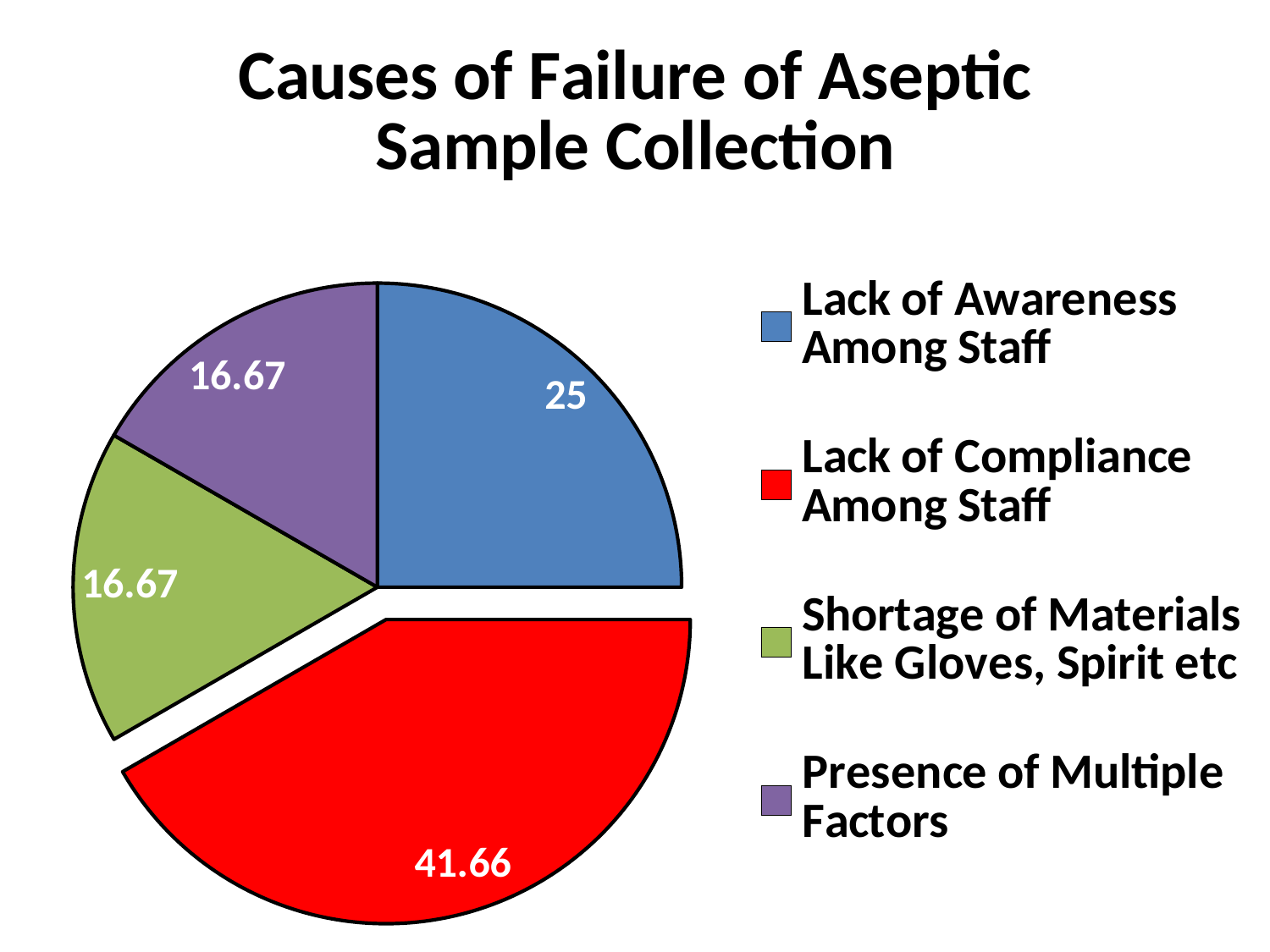
Which is larger, the value for Lack of Awareness Among Staff or the value for Shortage of Materials Like Gloves, Spirit etc? Lack of Awareness Among Staff What kind of chart is shown on the slide? Pie chart What is the value for Shortage of Materials Like Gloves, Spirit etc? 16.67 How many categories are shown in the pie chart? 4 Which category is shown in red? Lack of Compliance Among Staff What is the value for Lack of Compliance Among Staff? 41.66 What is the title of the chart? Causes of Failure of Aseptic Sample Collection What is the value for Lack of Awareness Among Staff? 25 What is the difference between the values for Lack of Compliance Among Staff and Lack of Awareness Among Staff? 16.66 What is the value for Presence of Multiple Factors? 16.67 What is the difference between the values for Lack of Awareness Among Staff and Presence of Multiple Factors? 8.33 Which category has the largest slice of the pie? Lack of Compliance Among Staff